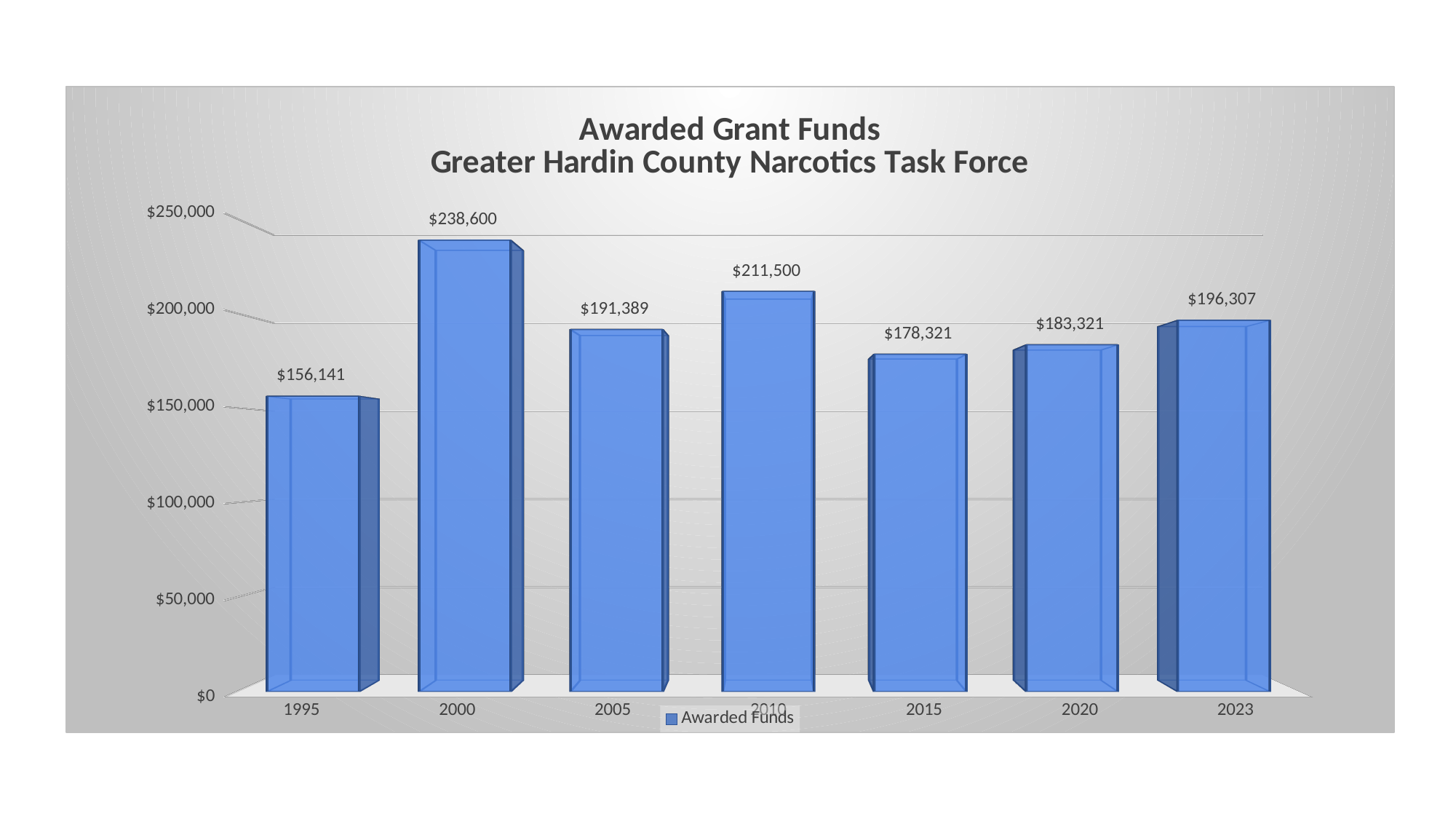
What is the difference between the awarded funds in 2020 and in 2015? $5,000 What was the awarded grant funds value for 2023? $196,307 Which year had the lowest awarded grant funds? 1995 How many years are shown on the x axis? 7 What was the awarded grant funds value for 2010? $211,500 Is the value for 2015 greater or less than $200,000? less What kind of chart is shown on the slide? Bar chart Which year had the highest awarded grant funds? 2000 Which year had larger awarded funds, 2005 or 2010? 2010 What is the difference between the awarded funds in 2000 and in 1995? $82,459 What series name does the legend show? Awarded Funds What was the awarded grant funds value for 1995? $156,141